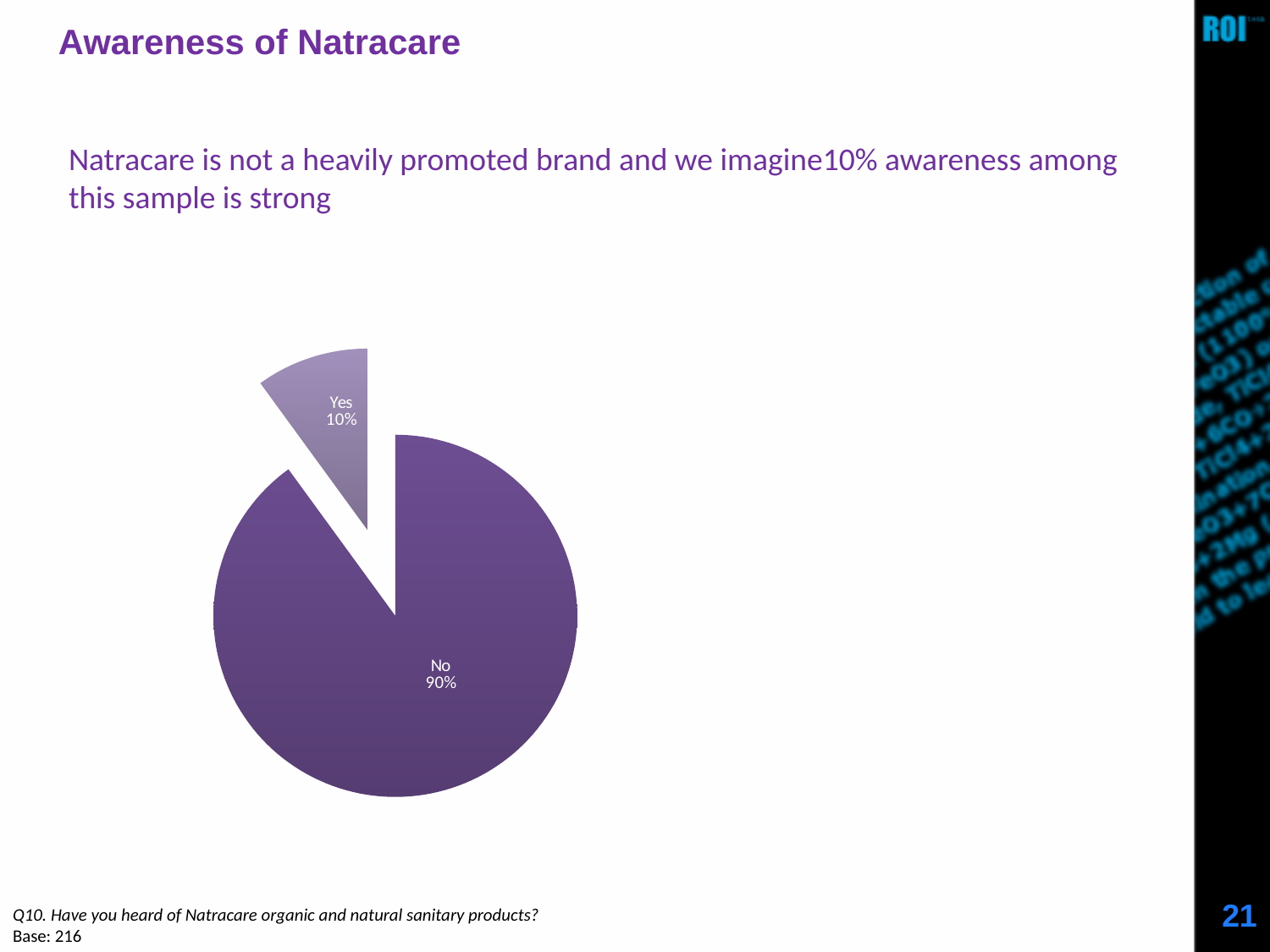
What percentage of respondents answered "No"? 90% Which slice is pulled out (exploded) from the pie? Yes What is the base (number of respondents) stated for the chart? 216 What percentage of respondents answered "Yes" to having heard of Natracare? 10% What is the difference in percentage points between the "No" and "Yes" slices? 80 Which slice of the pie is the smallest? Yes Which is larger, the "Yes" slice or the "No" slice? No What share of the pie does the "Yes" slice represent? 10% Which slice of the pie is the largest? No What kind of chart is shown on the slide? pie chart How many slices does the pie chart have? 2